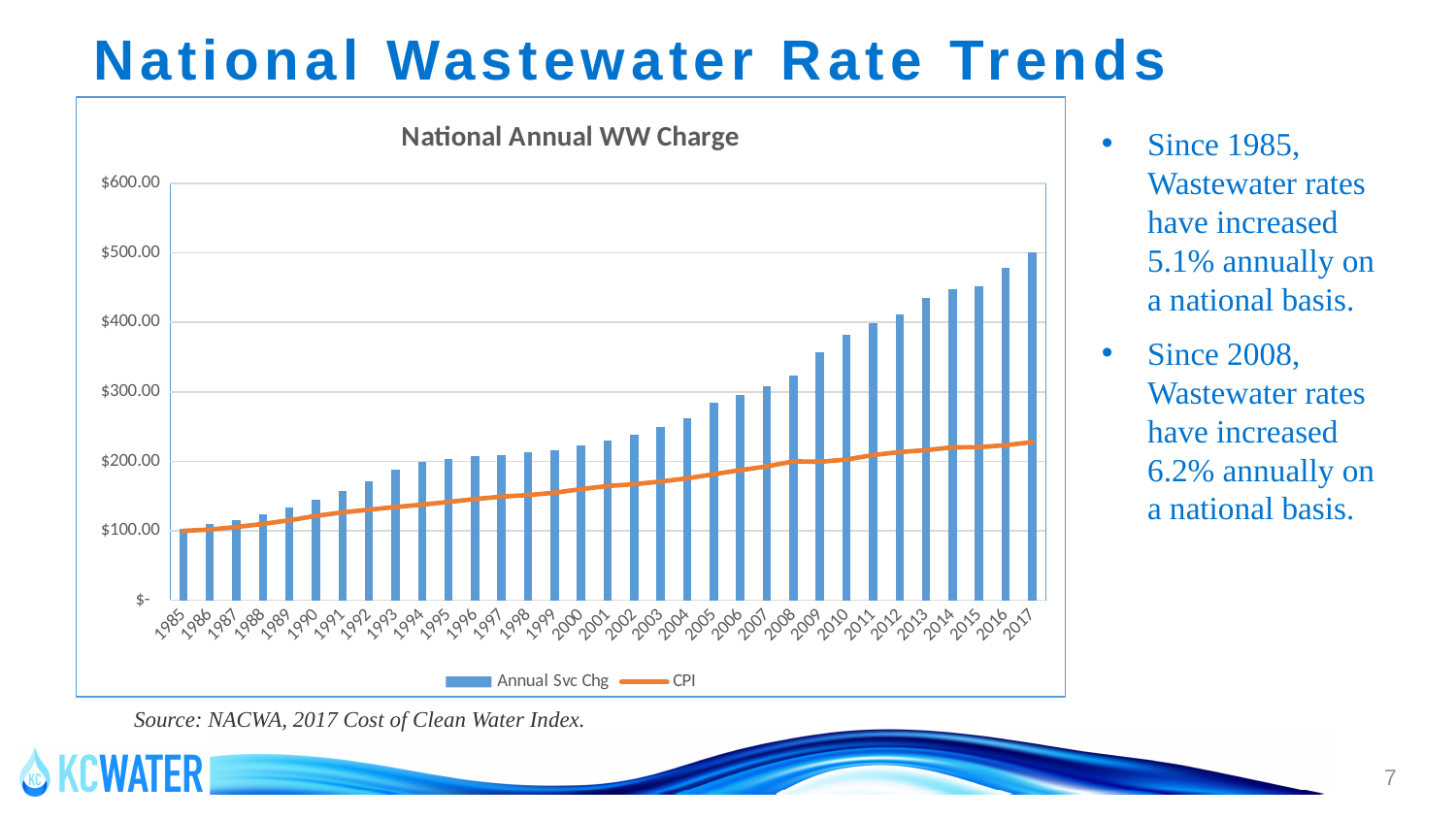
How many series does the legend list? 2 What kind of chart is shown on the slide? bar chart (with a line series) What are the two series named in the legend? Annual Svc Chg and CPI Is the CPI value for 2017 greater or less than $300.00? less Is the Annual Svc Chg value for 2010 greater or less than $400.00? less How many years are shown on the x axis? 33 Is the Annual Svc Chg value for 2016 greater or less than $500.00? less Do the Annual Svc Chg values rise or fall from 1985 to 2017? rise Which year has the lowest Annual Svc Chg bar? 1985 Which year has the highest Annual Svc Chg bar? 2017 In 2017, which is larger: the Annual Svc Chg bar or the CPI line? Annual Svc Chg